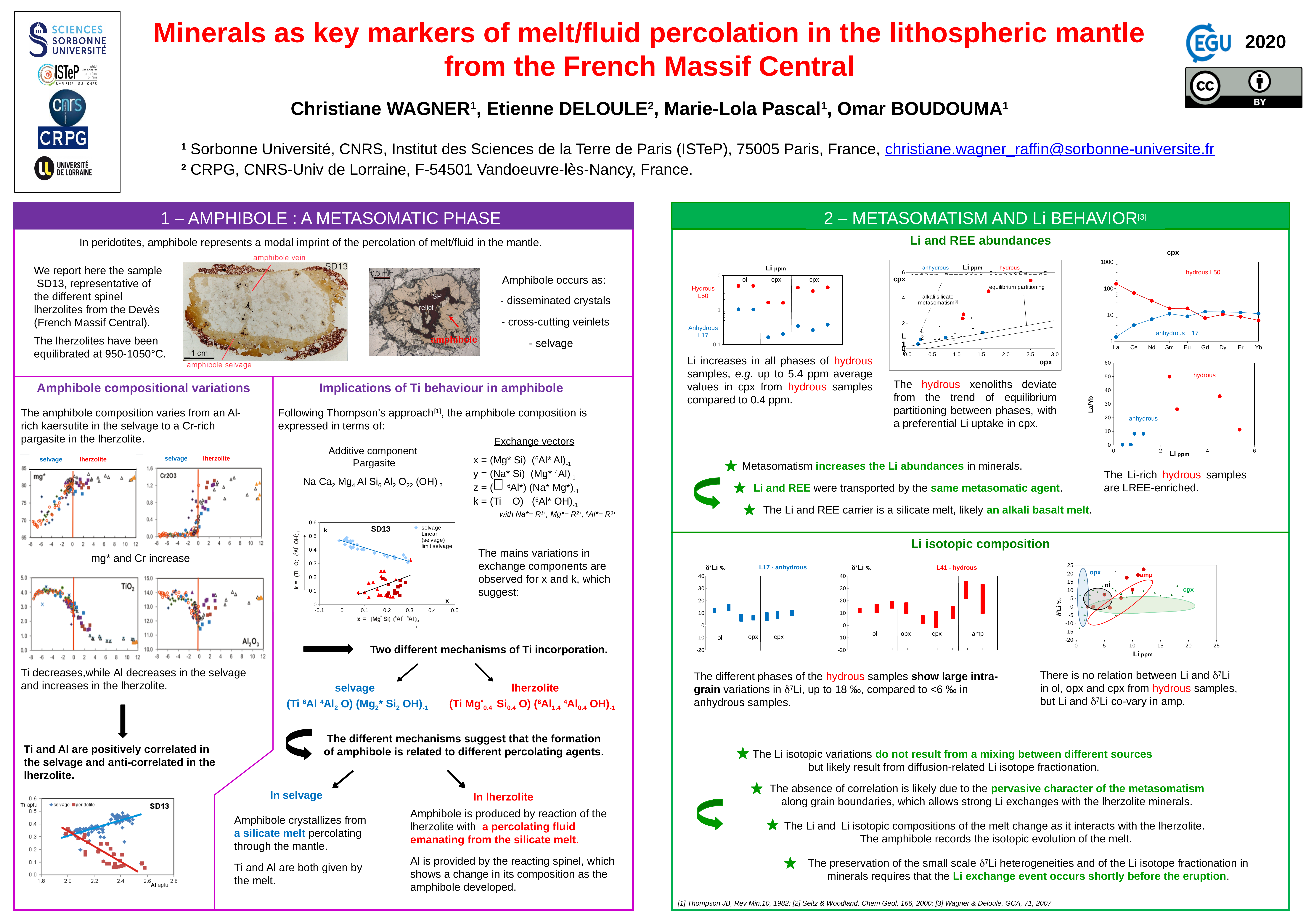
In the 'cpx' REE chart, how many elements are shown along the x axis? 9 How many entries does the legend list in the 'SD13' chart plotting k against x in the 'Implications of Ti behaviour in amphibole' section? 3 In the 'L41 - hydrous' δ7Li chart, how many mineral phases are shown along the x axis? 4 In the 'cpx' REE chart, which series has the higher value at La, hydrous L50 or anhydrous L17? hydrous L50 In the 'cpx' REE chart, do the hydrous L50 values rise or fall from La to Yb? fall How many series does the legend list in the 'SD13' chart plotting Ti apfu against Al apfu? 2 In the 'cpx' REE chart, is the anhydrous L17 value at La greater or less than 10? less In the 'cpx' REE chart, do the anhydrous L17 values rise or fall from La to Yb? rise In the δ7Li versus Li ppm chart at the bottom right, which phase is outlined in green? cpx What kind of chart is the 'SD13' chart plotting Ti apfu against Al apfu at the bottom left of the poster? scatter chart In the La/Yb versus Li ppm chart, which group has the higher La/Yb values, hydrous or anhydrous? hydrous In the La/Yb versus Li ppm chart, is the highest hydrous point greater or less than 40 La/Yb? greater